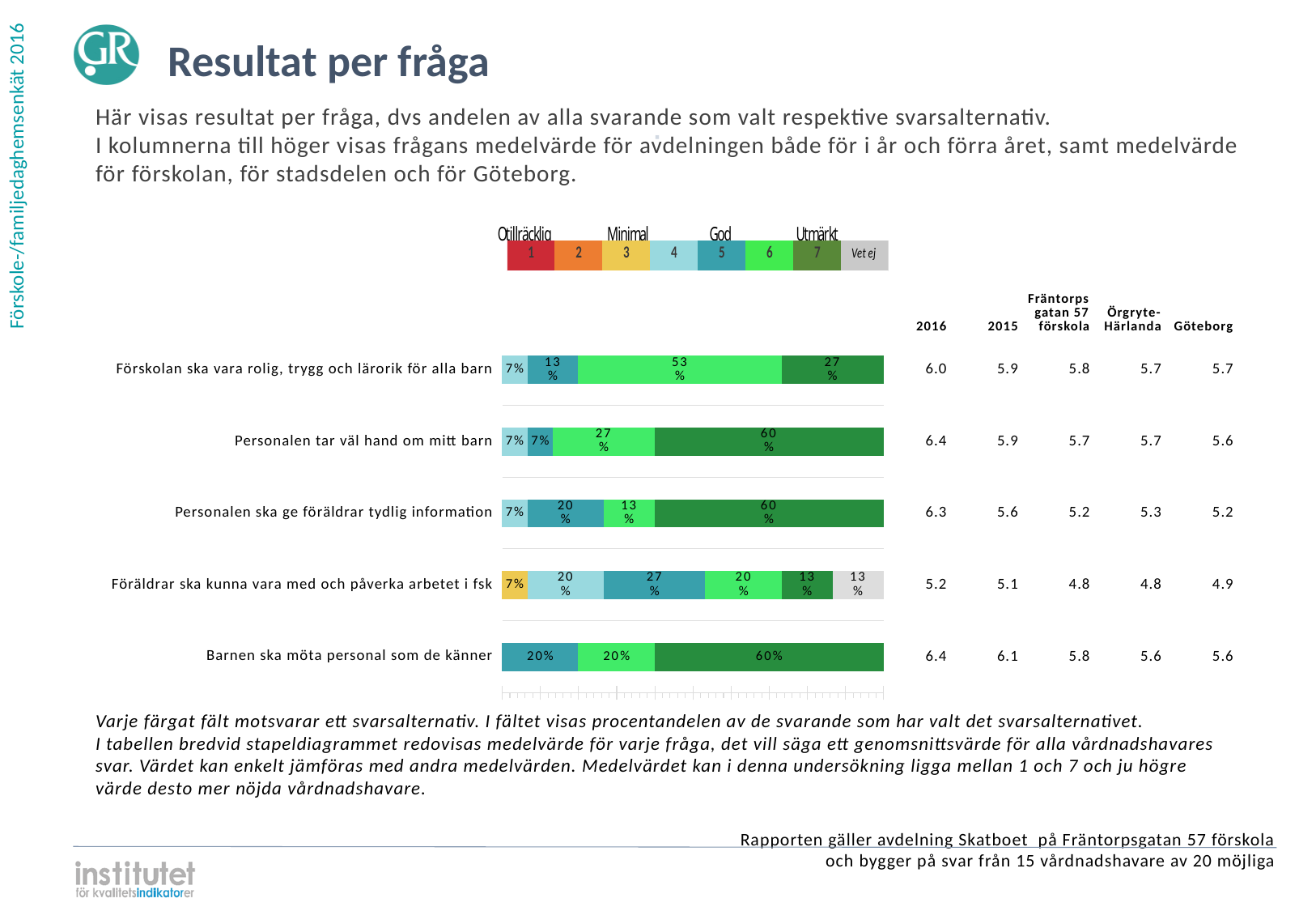
What percentage of respondents chose 7 (Utmärkt) for "Förskolan ska vara rolig, trygg och lärorik för alla barn"? 27% Which question has the largest share of respondents choosing 6? Förskolan ska vara rolig, trygg och lärorik för alla barn What percentage of respondents chose 6 for "Förskolan ska vara rolig, trygg och lärorik för alla barn"? 53% How many percentage points larger is the share choosing 7 for "Personalen tar väl hand om mitt barn" than for "Förskolan ska vara rolig, trygg och lärorik för alla barn"? 33 percentage points Which question has the smallest share of respondents choosing 7? Föräldrar ska kunna vara med och påverka arbetet i fsk What percentage of respondents chose 7 for "Barnen ska möta personal som de känner"? 60% How many questions (categories) are plotted as bars in the chart? 5 How many coloured segments make up the bar for "Föräldrar ska kunna vara med och påverka arbetet i fsk"? 6 Which has the larger share of respondents choosing 5: "Personalen ska ge föräldrar tydlig information" or "Personalen tar väl hand om mitt barn"? Personalen ska ge föräldrar tydlig information What kind of chart is shown on the slide? Stacked bar chart What percentage of respondents answered "Vet ej" for "Föräldrar ska kunna vara med och påverka arbetet i fsk"? 13% How many entries does the colour legend above the chart contain, including "Vet ej"? 8